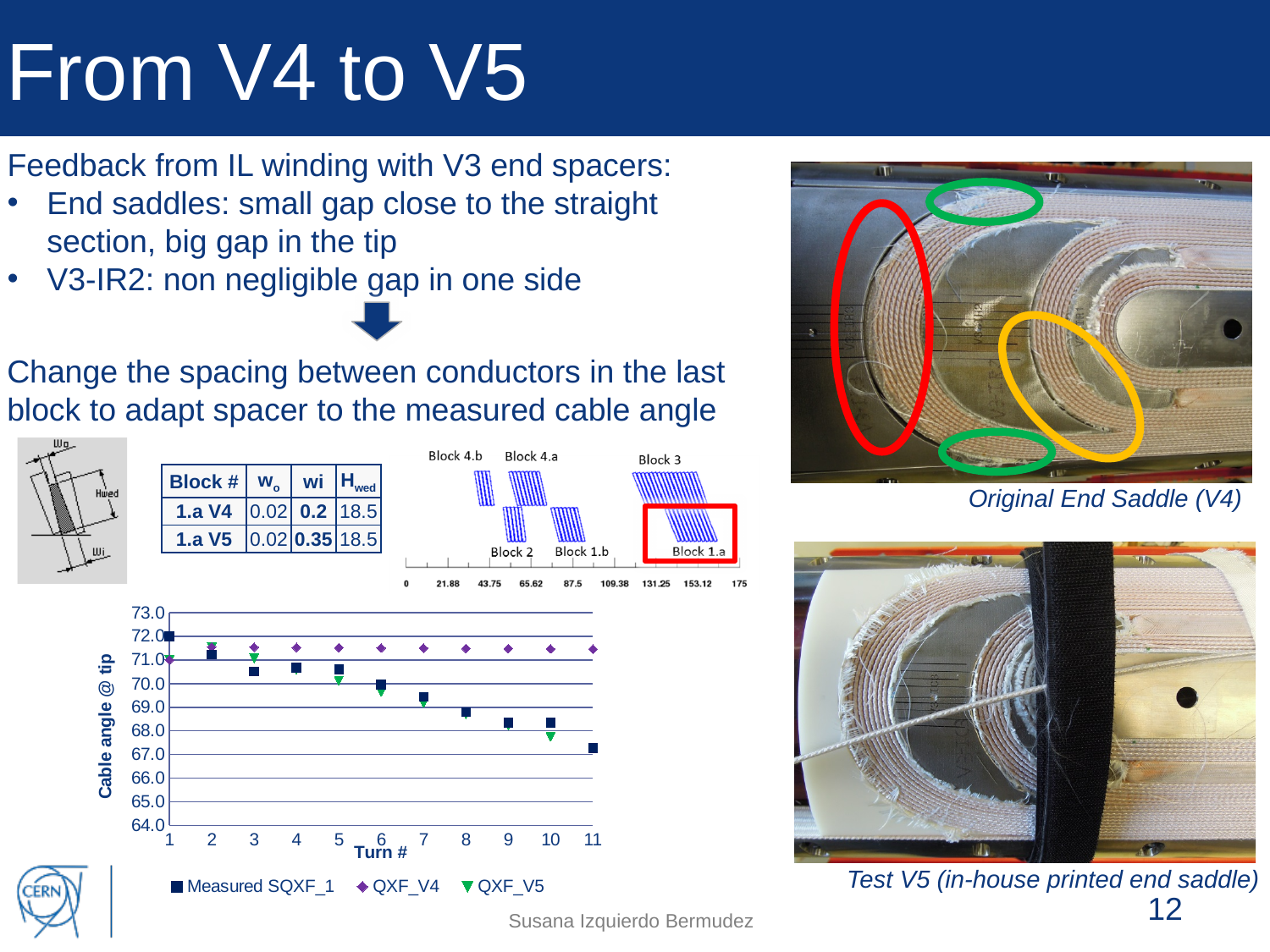
How many series does the legend of the cable angle chart list? 3 What is the title of the y axis of the cable angle chart? Cable angle @ tip Is the QXF_V4 value at turn 11 greater or less than 71.0? greater What kind of chart is shown at the bottom left of the slide? scatter chart At turn 11, which series has the larger cable angle, Measured SQXF_1 or QXF_V4? QXF_V4 Do the Measured SQXF_1 values rise or fall as the turn number increases? fall At which turn number is the Measured SQXF_1 cable angle highest? 1 At which turn number is the Measured SQXF_1 cable angle lowest? 11 Is the Measured SQXF_1 value at turn 11 greater or less than 68.0? less How many turn numbers are shown on the x axis of the cable angle chart? 11 What is the title of the x axis of the cable angle chart? Turn # Is the Measured SQXF_1 value at turn 1 greater or less than 71.0? greater